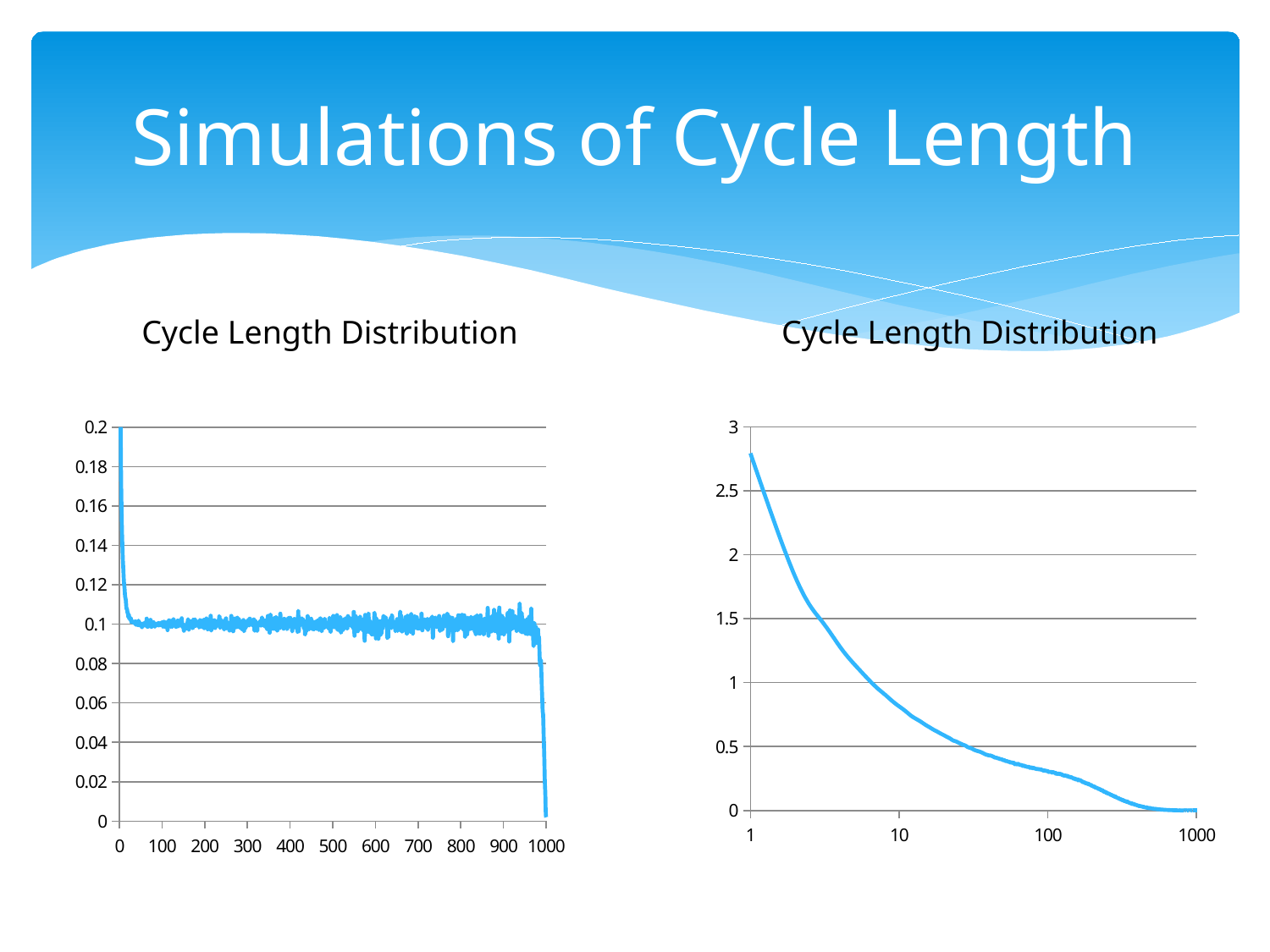
On the chart on the right of the slide, which is larger, the value at x = 1 or the value at x = 100? the value at x = 1 On the chart on the right of the slide, is the value at x = 10 greater or less than 1? less What kind of chart is the chart on the left of the slide? line chart On the chart on the left of the slide, is the value at x = 500 greater or less than 0.08? greater On the chart on the right of the slide, is the value at x = 100 greater or less than 0.5? less On the chart on the right of the slide, what is the highest value shown on the y axis? 3 What is the title of the chart on the left of the slide? Cycle Length Distribution What kind of chart is the chart on the right of the slide? line chart On the chart on the right of the slide, does the line rise or fall as x increases from 1 to 1000? fall